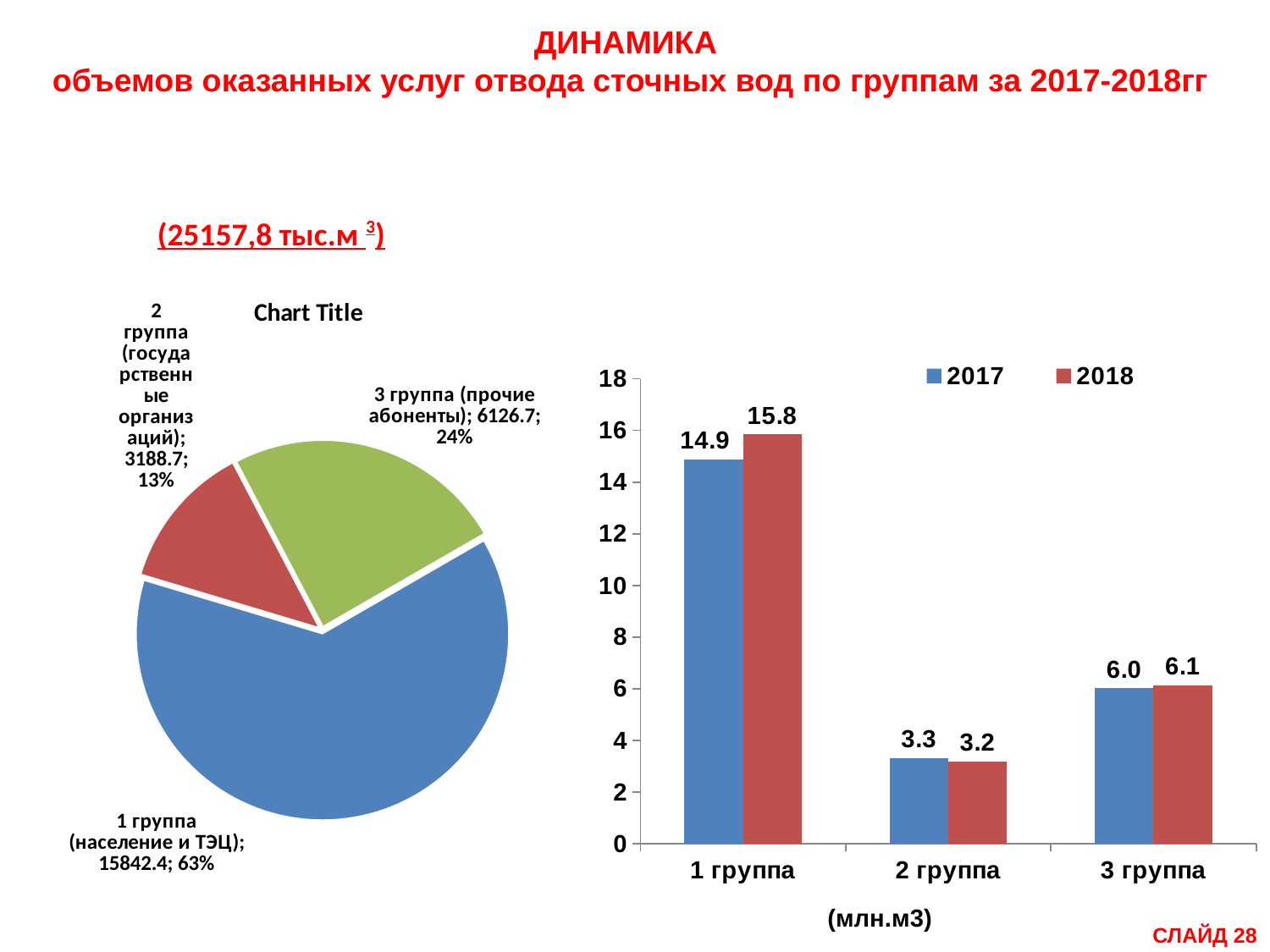
In the bar chart on the right, what is the difference between the 2018 and 2017 values for 1 группа? 0.9 In the bar chart on the right, which group has the highest value in 2017? 1 группа In the pie chart on the left, what share does 3 группа (прочие абоненты) have? 24% In the bar chart on the right, what is the value for 3 группа in 2018? 6.1 In the pie chart on the left, which group has the largest slice? 1 группа (население и ТЭЦ) In the bar chart on the right, which group has the lowest value in 2018? 2 группа In the bar chart on the right, what is the value for 2 группа in 2017? 3.3 In the bar chart on the right, which is larger for 2 группа: the 2017 value or the 2018 value? 2017 What kind of chart is the chart on the left of the slide? Pie chart In the pie chart on the left, what is the value for 2 группа (государственные организаций)? 3188.7 How many series does the legend of the bar chart on the right list? 2 In the bar chart on the right, what is the value for 1 группа in 2018? 15.8